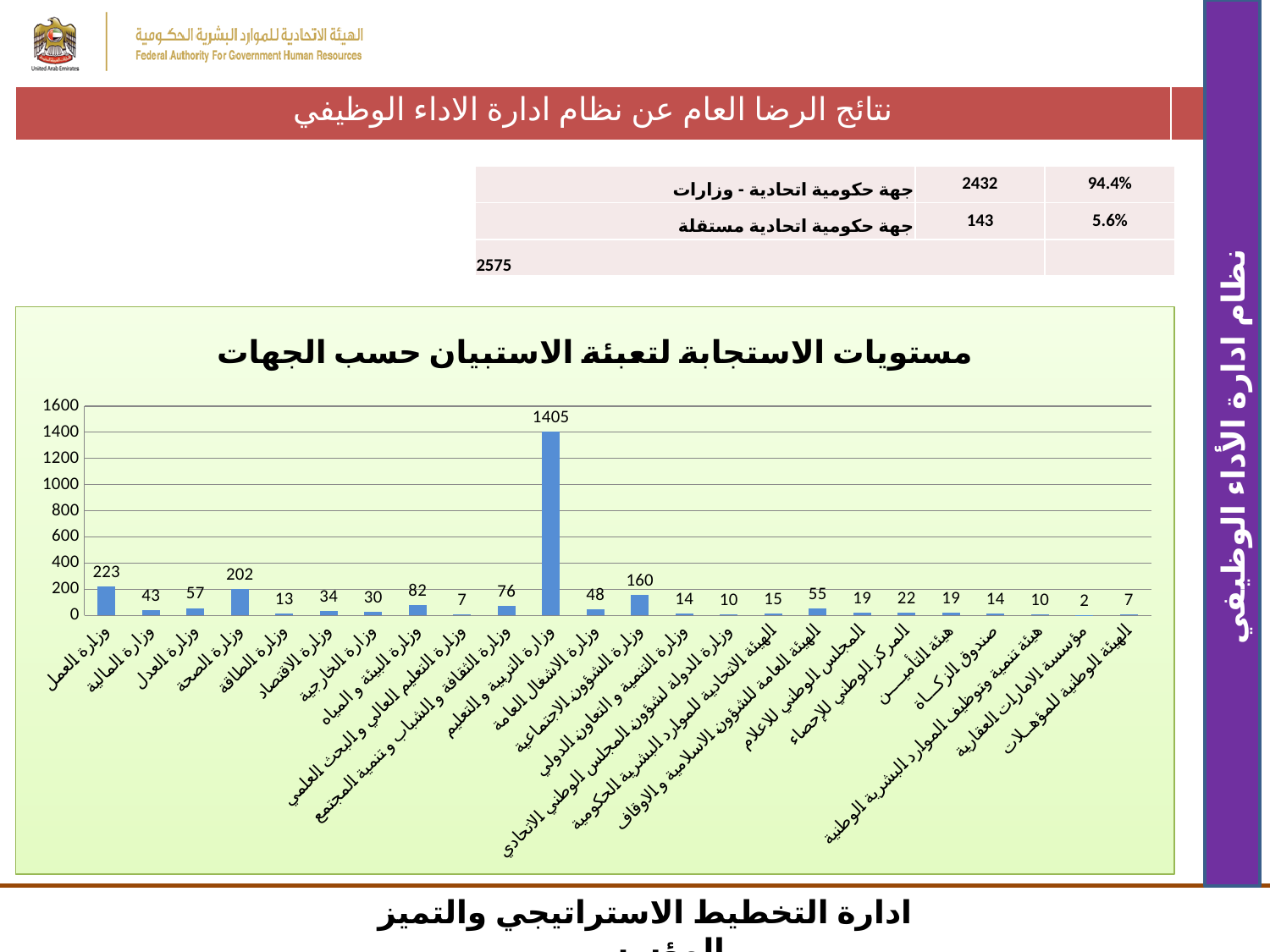
Which is larger, the value for وزارة البيئة و المياه or the value for وزارة الثقافة و الشباب و تنمية المجتمع? وزارة البيئة و المياه What is the value for الهيئة العامة للشؤون الاسلامية و الاوقاف? 55 How many categories are shown on the x axis of the chart? 24 What is the value for وزارة العمل? 223 What is the value for وزارة التربية و التعليم? 1405 What is the title of the chart? مستويات الاستجابة لتعبئة الاستبيان حسب الجهات Which category has the lowest value? مؤسسة الامارات العقارية Which category has the highest value? وزارة التربية و التعليم What type of chart is shown on the slide? bar chart What is the value for وزارة الشؤون الاجتماعية? 160 What is the difference between the values for وزارة العمل and وزارة الصحة? 21 Is the value for وزارة التربية و التعليم greater or less than 1200? greater